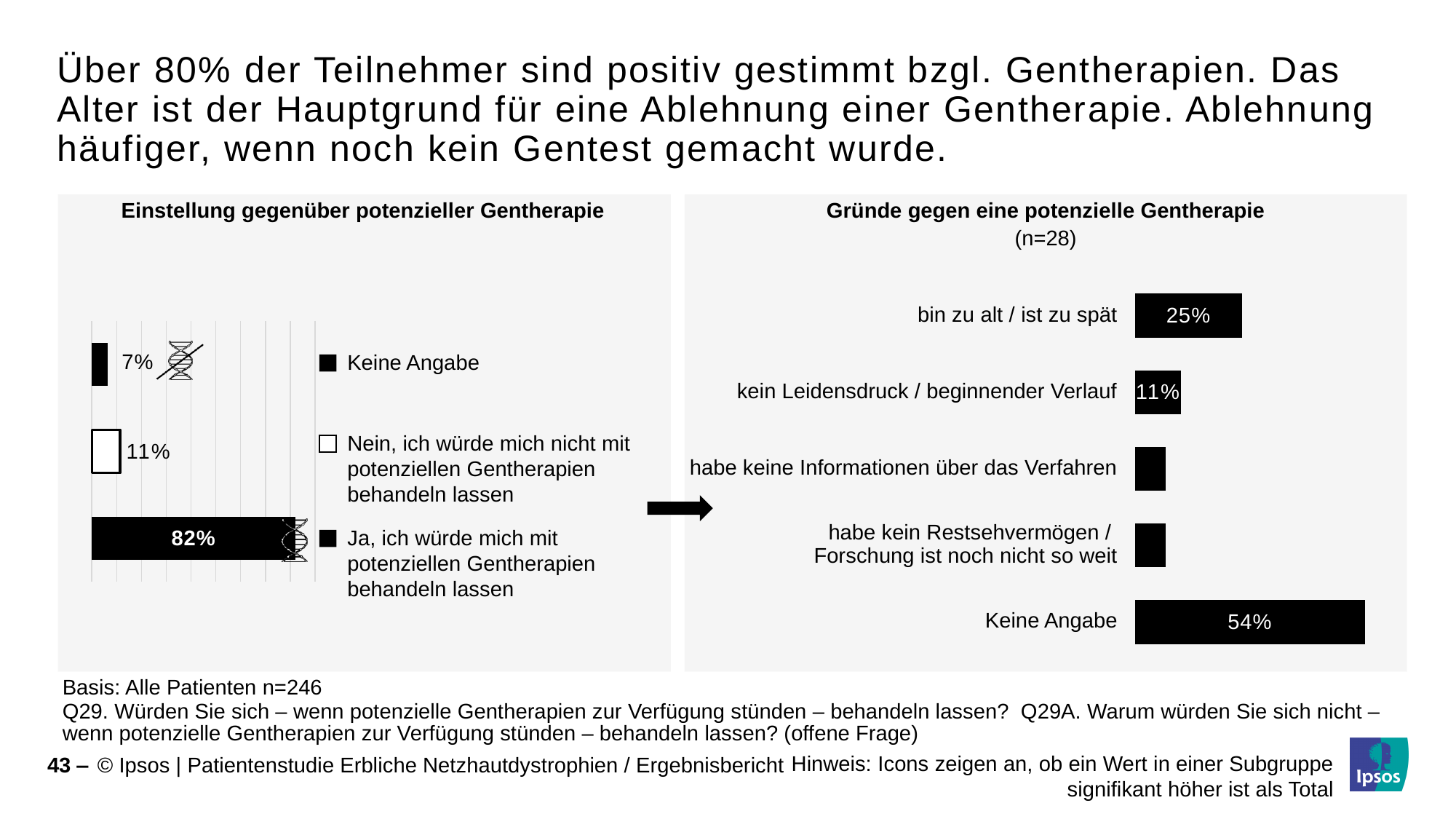
In the chart 'Einstellung gegenüber potenzieller Gentherapie', which category has the highest value? Ja, ich würde mich mit potenziellen Gentherapien behandeln lassen In the chart 'Gründe gegen eine potenzielle Gentherapie', how many categories are shown? 5 In the chart 'Einstellung gegenüber potenzieller Gentherapie', what is the value for 'Keine Angabe'? 7% In the chart 'Einstellung gegenüber potenzieller Gentherapie', what percentage of participants answered 'Ja, ich würde mich mit potenziellen Gentherapien behandeln lassen'? 82% How many entries does the legend of the chart 'Einstellung gegenüber potenzieller Gentherapie' list? 3 In the chart 'Gründe gegen eine potenzielle Gentherapie', what is the value for 'Keine Angabe'? 54% In the chart 'Gründe gegen eine potenzielle Gentherapie', what is the value for 'bin zu alt / ist zu spät'? 25% In the chart 'Gründe gegen eine potenzielle Gentherapie', which category has the highest value? Keine Angabe In the chart 'Gründe gegen eine potenzielle Gentherapie', what is the value for 'kein Leidensdruck / beginnender Verlauf'? 11% In the chart 'Einstellung gegenüber potenzieller Gentherapie', what percentage answered 'Nein, ich würde mich nicht mit potenziellen Gentherapien behandeln lassen'? 11% In the chart 'Einstellung gegenüber potenzieller Gentherapie', what is the difference between the 'Ja' and 'Nein' values? 71 percentage points What kind of chart is 'Gründe gegen eine potenzielle Gentherapie'? Bar chart